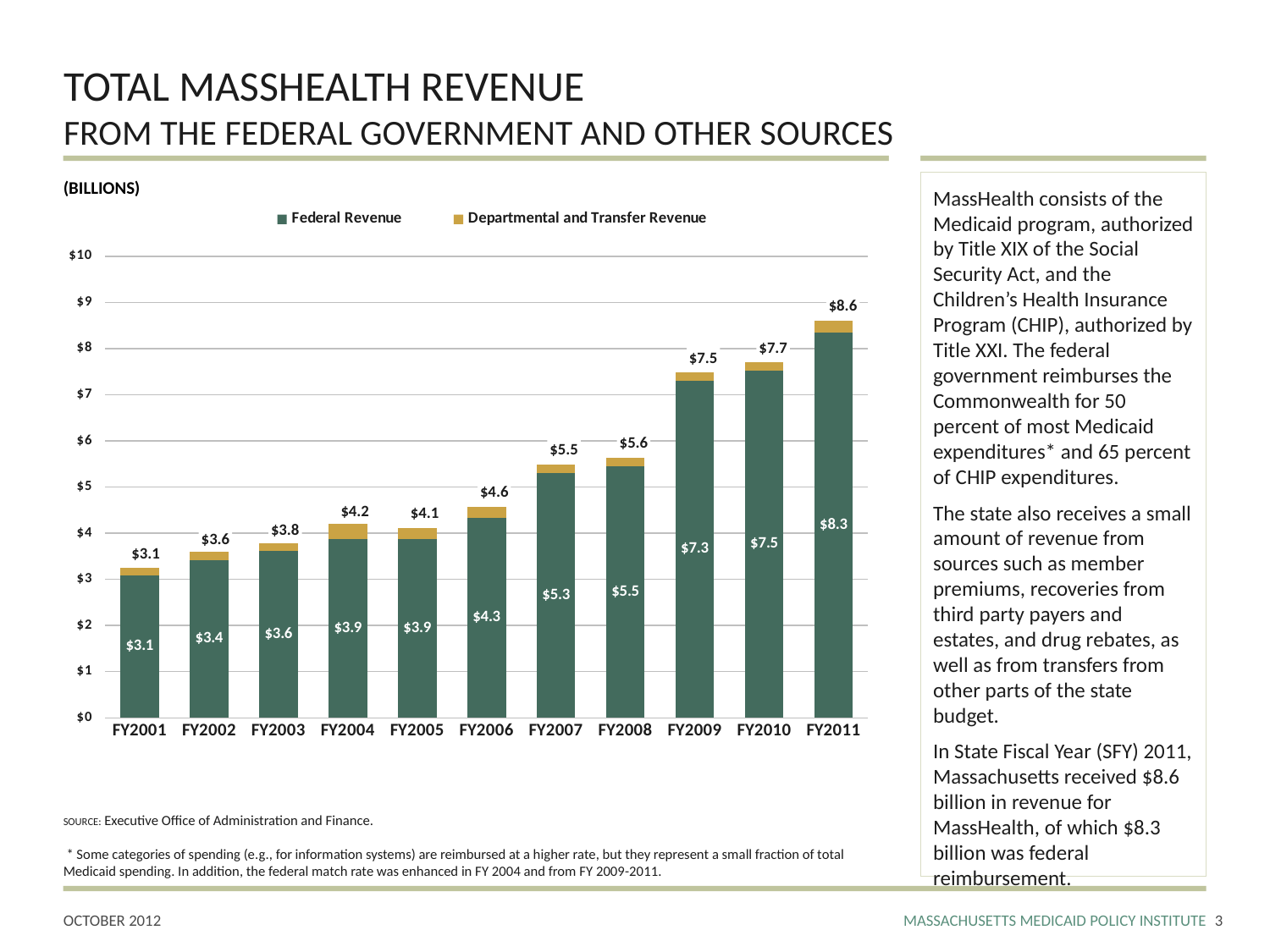
What is the difference between the total revenue in FY2011 and FY2001? $5.5 What is the total MassHealth revenue shown for FY2009? $7.5 Which fiscal year has the lowest total revenue? FY2001 Is the Federal Revenue value for FY2007 greater or less than $5? greater What kind of chart is shown on the slide? Stacked bar chart What is the Federal Revenue value for FY2006? $4.3 What is the Federal Revenue value for FY2011? $8.3 Which year has the larger total revenue, FY2004 or FY2005? FY2004 Which fiscal year has the highest total revenue? FY2011 Do total revenues generally rise or fall from FY2001 to FY2011? Rise How many fiscal years are shown on the x axis? 11 How many series does the legend list? 2